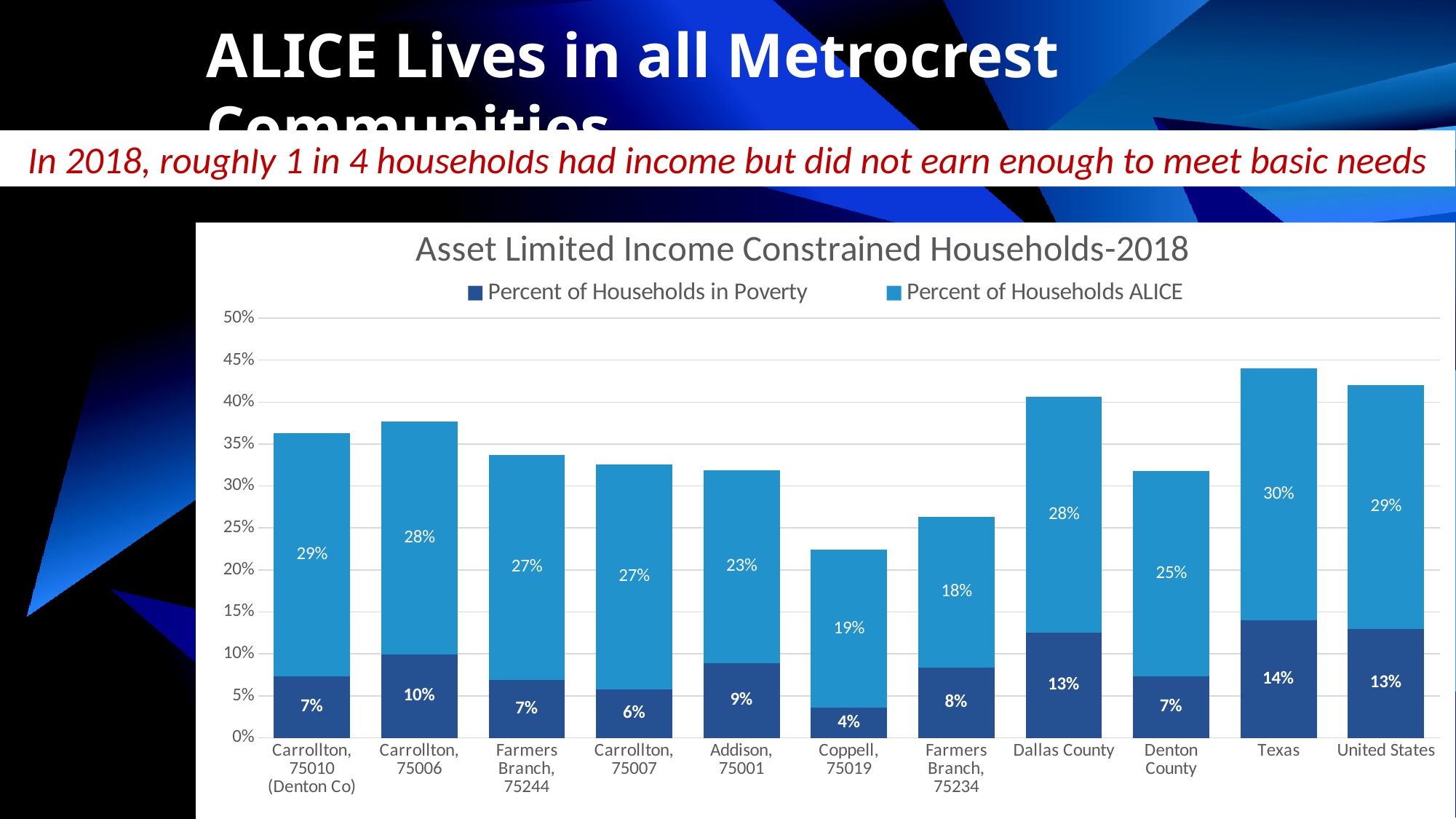
What is the Percent of Households ALICE for Dallas County? 28% Which category has the lowest Percent of Households ALICE? Farmers Branch, 75234 Which category has the highest Percent of Households ALICE? Texas Which is larger: the Percent of Households in Poverty for Carrollton, 75006 or for Addison, 75001? Carrollton, 75006 What is the Percent of Households in Poverty for Texas? 14% What is the total of the stacked bar for Texas? 44% How many categories are shown on the x axis? 11 What is the difference between the Percent of Households ALICE for Carrollton, 75010 (Denton Co) and Addison, 75001? 6% How many series does the legend list? 2 What type of chart is shown on the slide? Stacked bar chart What is the Percent of Households in Poverty for Coppell, 75019? 4% Which category has the lowest Percent of Households in Poverty? Coppell, 75019